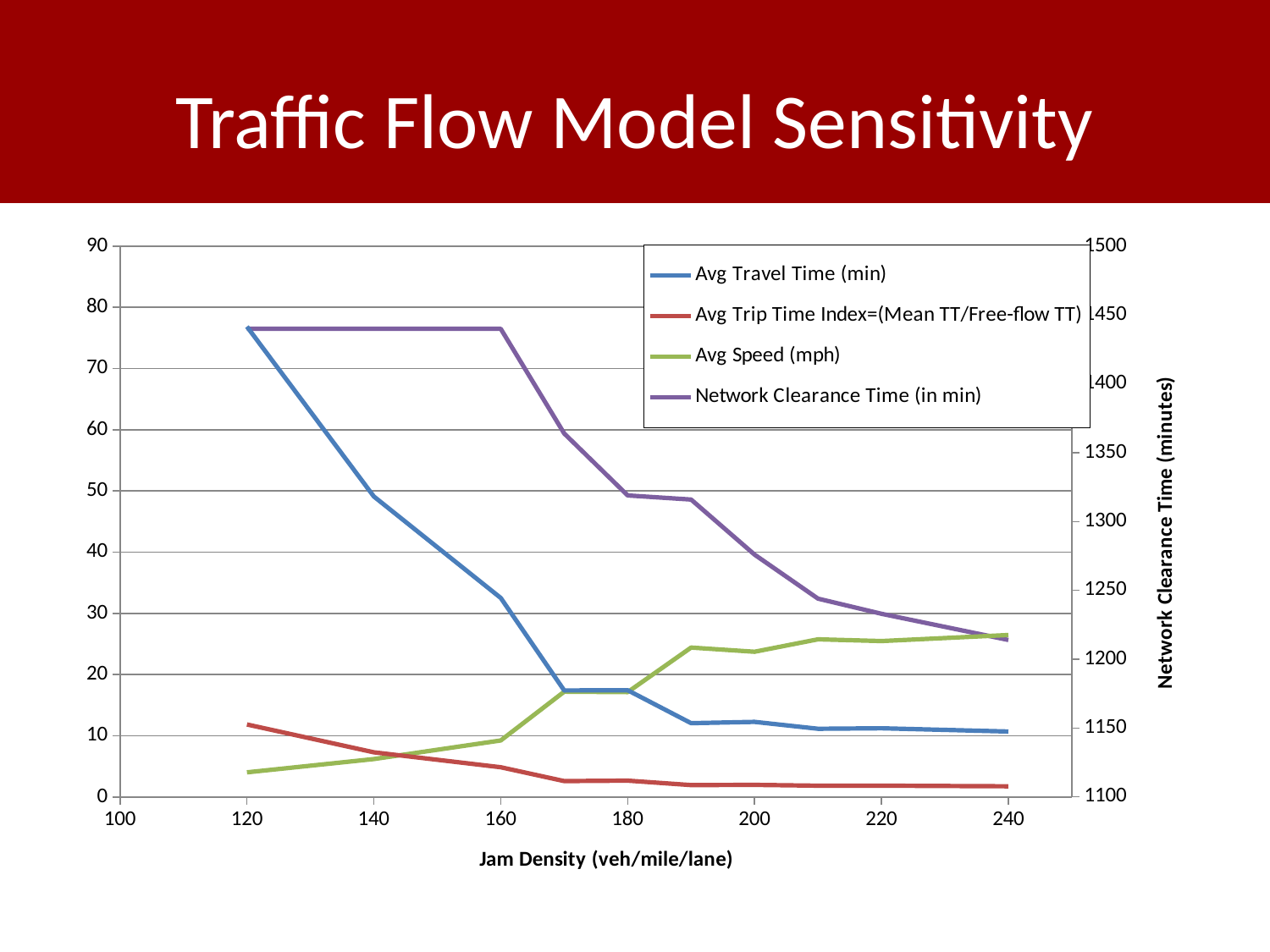
Is the value of Network Clearance Time (in min) at a jam density of 240 greater or less than 1250? less Is the value of Avg Speed (mph) at a jam density of 120 greater or less than 10? less What is the title of the x axis? Jam Density (veh/mile/lane) Does Network Clearance Time (in min) rise or fall as jam density increases from 160 to 240? fall Does Avg Travel Time (min) rise or fall as jam density increases from 120 to 240? fall At a jam density of 240, which is larger: Avg Speed (mph) or Avg Travel Time (min)? Avg Speed (mph) Does Avg Speed (mph) rise or fall as jam density increases from 120 to 240? rise What is the title of the right-hand (secondary) y axis? Network Clearance Time (minutes) Is the value of Network Clearance Time (in min) at a jam density of 120 greater or less than 1400? greater How many series does the legend list? 4 What kind of chart is shown on the slide? line chart